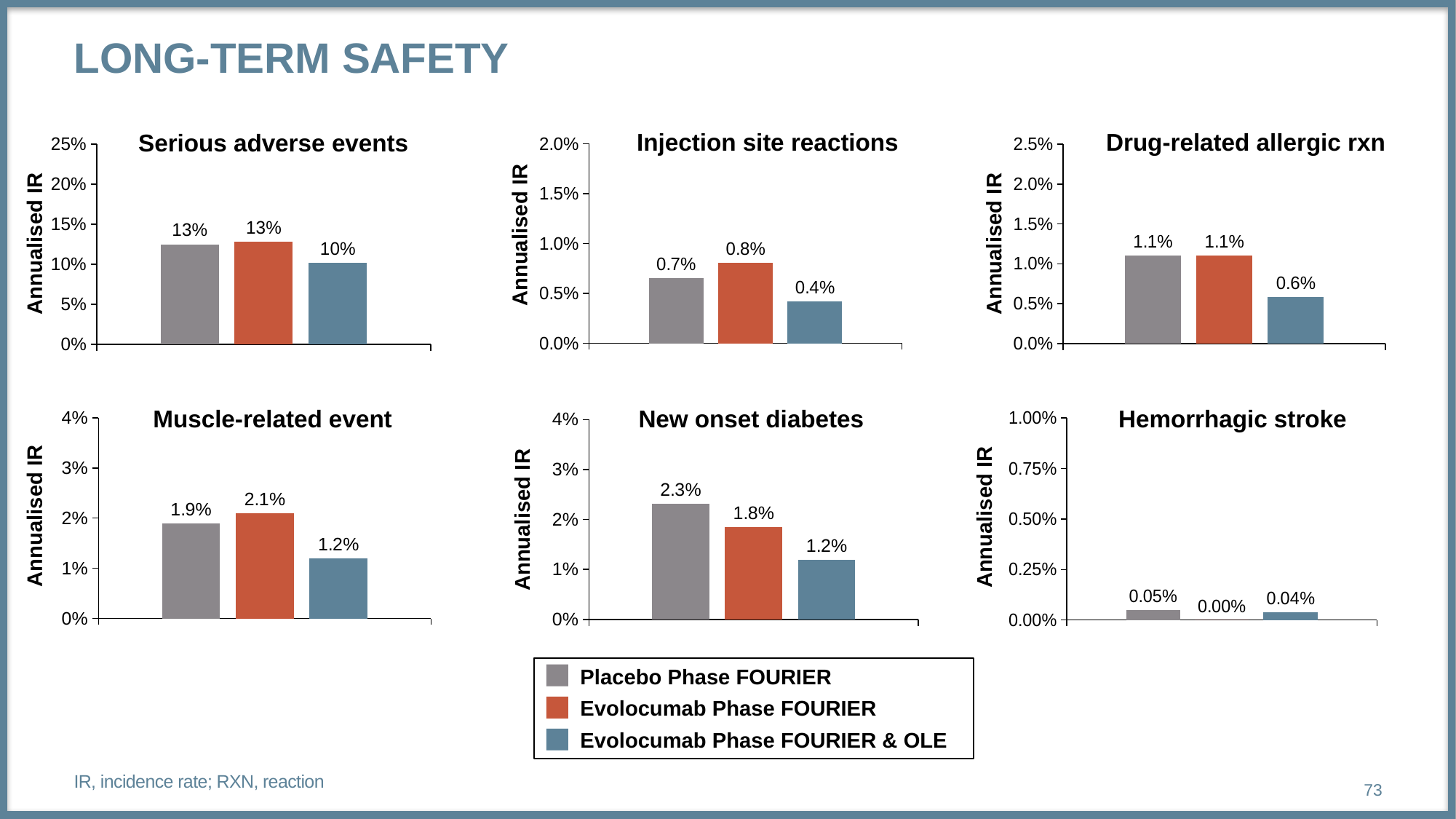
In the 'Drug-related allergic rxn' chart, what is the annualised IR for Evolocumab Phase FOURIER & OLE? 0.6% In the 'Serious adverse events' chart, what is the annualised IR for Evolocumab Phase FOURIER & OLE? 10% In the 'Injection site reactions' chart, is the value for Placebo Phase FOURIER larger or smaller than the value for Evolocumab Phase FOURIER & OLE? larger In the 'Injection site reactions' chart, what is the annualised IR for Evolocumab Phase FOURIER? 0.8% What type of chart is 'Serious adverse events'? Bar chart In the 'Muscle-related event' chart, which series has the highest annualised IR? Evolocumab Phase FOURIER In the 'New onset diabetes' chart, what is the difference between the Placebo Phase FOURIER and Evolocumab Phase FOURIER values? 0.5% How many charts are shown on the slide? 6 How many series does the legend list? 3 In the 'New onset diabetes' chart, which series has the lowest annualised IR? Evolocumab Phase FOURIER & OLE In the 'Muscle-related event' chart, is the value for Evolocumab Phase FOURIER & OLE greater or less than 2%? less In the 'Hemorrhagic stroke' chart, what is the annualised IR for Evolocumab Phase FOURIER? 0.00%